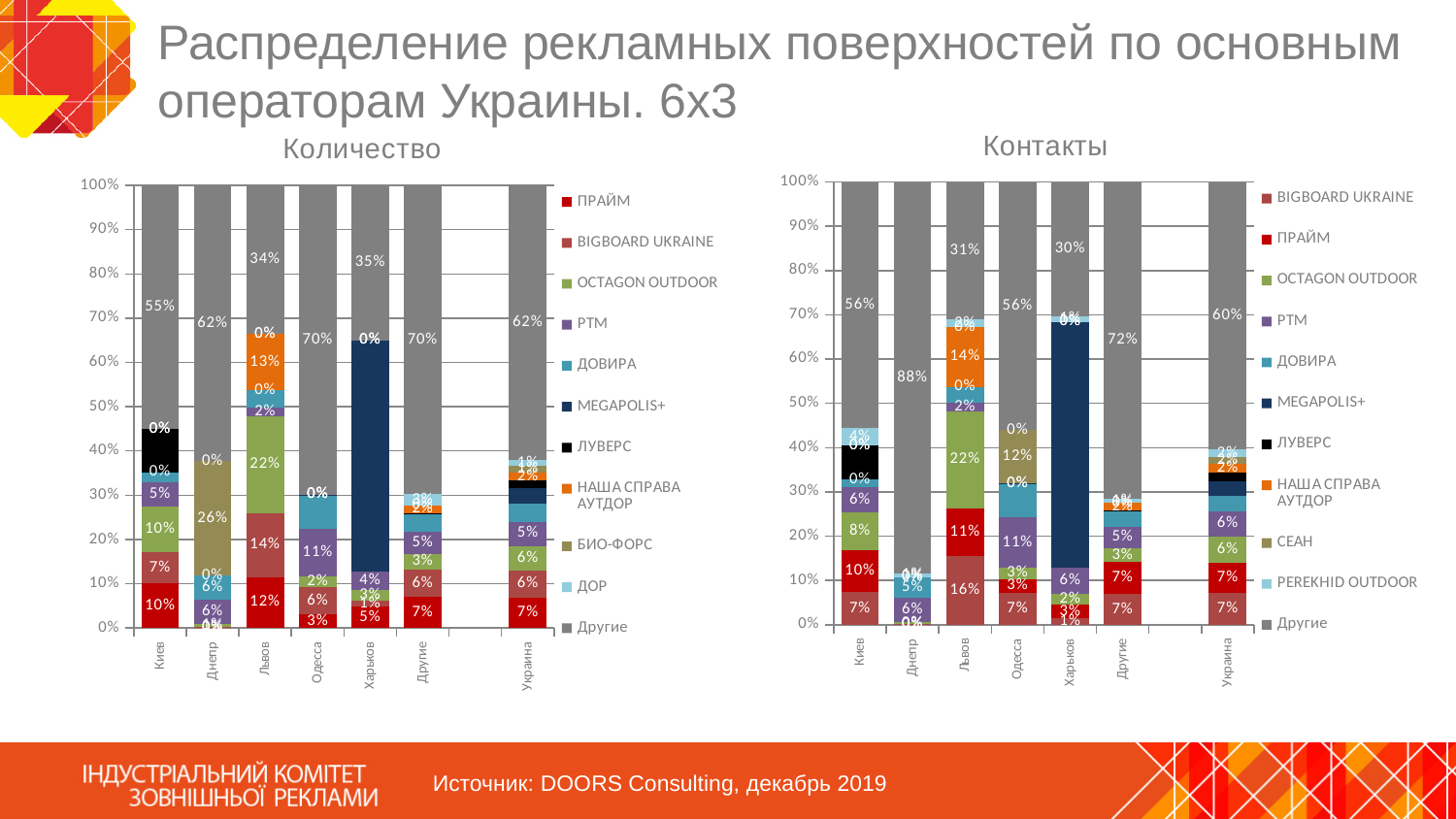
On the 'Контакты' chart, what is the difference between the 'Другие' share for Другие (72%) and for Харьков (30%)? 42% On the 'Количество' chart, what share does 'Другие' (the grey segment) have for Киев? 55% What type of chart is the 'Контакты' chart? Stacked bar chart On the 'Контакты' chart, what is the value of СЕАН for Одесса? 12% On the 'Количество' chart, which category has the smallest 'Другие' (grey) share? Львов On the 'Контакты' chart, which city has the largest 'Другие' (grey) share? Днепр How many categories are shown on the x axis of the 'Контакты' chart? 7 How many series does the legend of the 'Количество' chart list? 11 On the 'Количество' chart, which is larger for Львов: the BIGBOARD UKRAINE share or the ПРАЙМ share? BIGBOARD UKRAINE On the 'Количество' chart, what is the OCTAGON OUTDOOR share for Львов? 22% On the 'Контакты' chart, what share does 'Другие' (the grey segment) have for Днепр? 88% On the 'Количество' chart, what is the value of БИО-ФОРС for Днепр? 26%